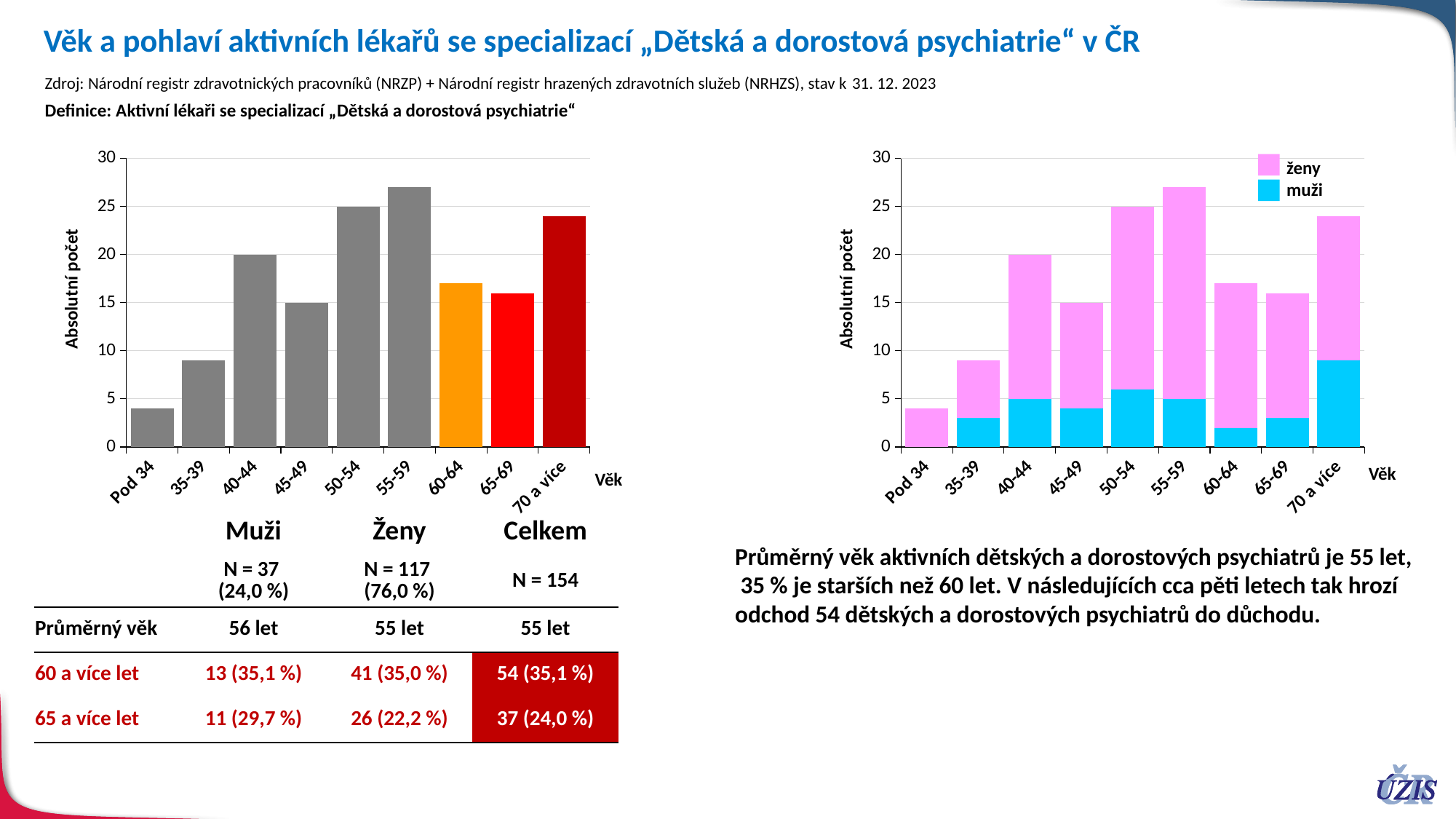
How many age groups are shown on the x axis of the right chart? 9 On the left chart, is the value for 35-39 greater or less than 10? less What kind of chart is the right chart? stacked bar chart On the left chart, is the value for 70 a více greater or less than 20? greater On the left chart, what is the value for the 45-49 age group? 15 How many series does the legend of the right chart list? 2 On the left chart, which is larger, the value for 40-44 or for 45-49? 40-44 On the left chart, what is the difference between the values for 50-54 and 40-44? 5 On the left chart, what is the value for the 40-44 age group? 20 On the left chart, what is the value for the 50-54 age group? 25 On the left chart, which age group has the highest value? 55-59 On the left chart, which age group has the lowest value? Pod 34